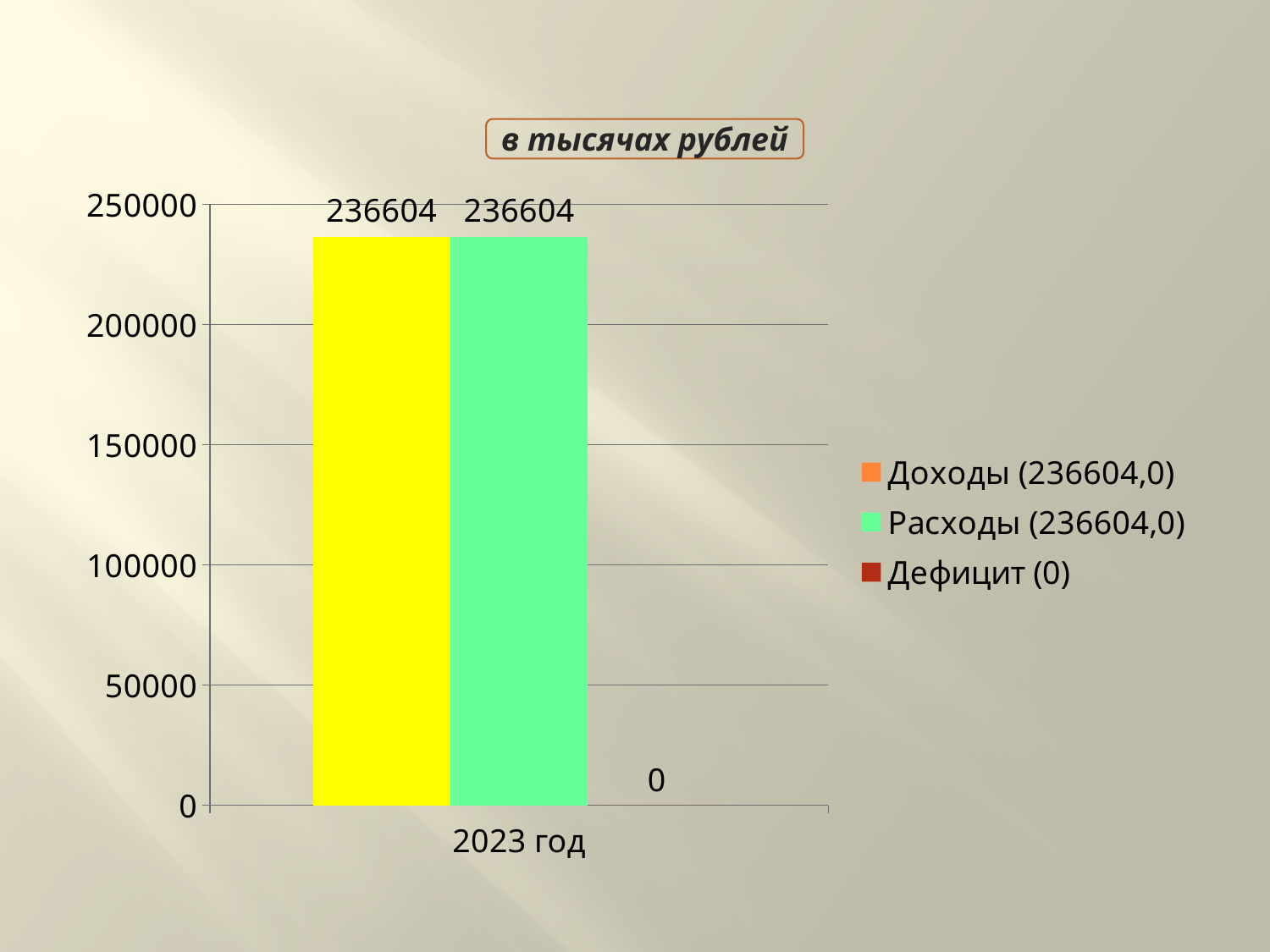
Which is larger in 2023 год, Доходы or Дефицит? Доходы What is the difference between the values for Доходы and Расходы in 2023 год? 0 What is the value for Дефицит in 2023 год? 0 What is the title of the chart? в тысячах рублей Which series has the lowest value in 2023 год? Дефицит What kind of chart is shown on the slide? bar chart What is the value for Доходы in 2023 год? 236604 What colour is the bar for Расходы? green How many categories are shown on the x axis? 1 How many series does the legend list? 3 Is the value for Расходы in 2023 год greater or less than 200000? greater What is the value for Расходы in 2023 год? 236604